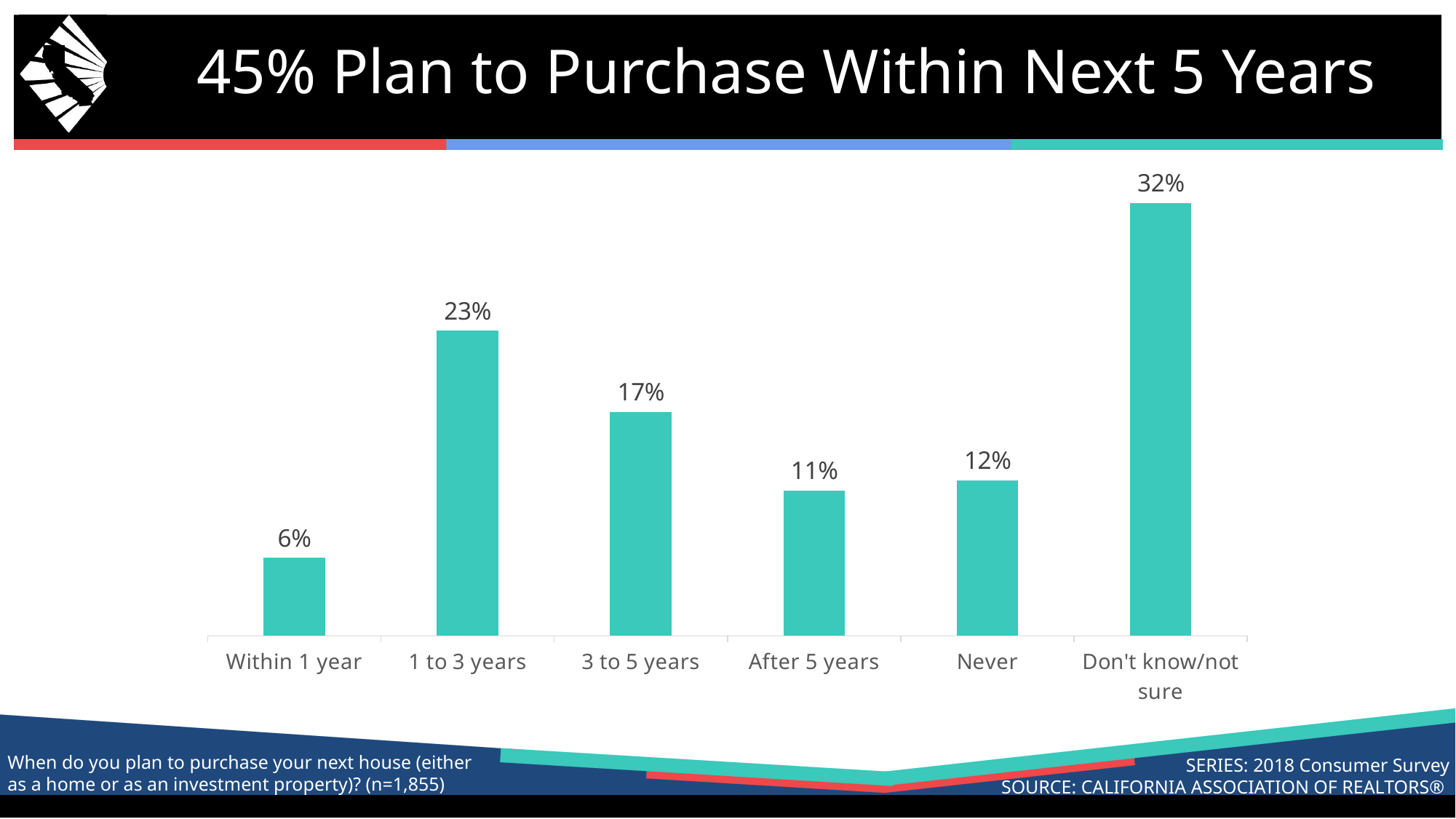
What percentage of respondents answered 'Never'? 12% What percentage of respondents plan to purchase within 1 year? 6% How many categories are shown on the x axis? 6 What is the difference between the 'Don't know/not sure' value and the 'Within 1 year' value? 26% What kind of chart is shown on the slide? Bar chart Which category has the lowest value? Within 1 year Which is larger, the value for 'After 5 years' or the value for 'Never'? Never What is the difference between the '1 to 3 years' value and the '3 to 5 years' value? 6% What is the combined value of the 'Within 1 year', '1 to 3 years' and '3 to 5 years' categories? 46% What is the title of the slide? 45% Plan to Purchase Within Next 5 Years What is the value shown for the '1 to 3 years' category? 23% Which category has the highest value? Don't know/not sure